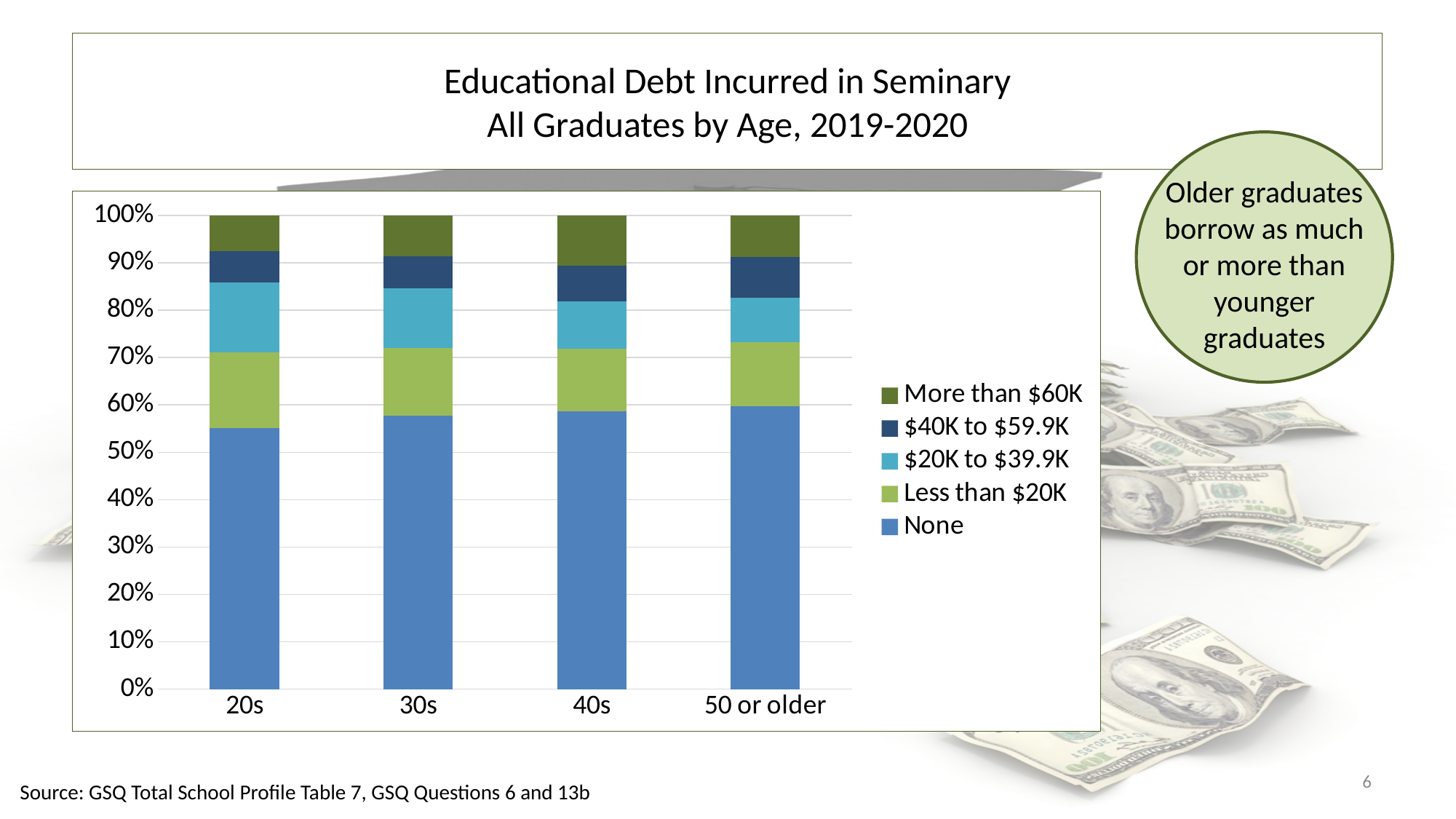
Is the 'None' share for the 50 or older group greater or less than 50%? greater Does the 'None' share rise or fall as age increases from 20s to 50 or older? rise Which age group has the smallest 'None' share? 20s What kind of chart is shown on the slide? Stacked bar chart How many series does the legend list? 5 Is the 'None' share for the 20s group greater or less than 60%? less What is the total of the stacked bar for the 40s group? 100% Is the 'None' share for the 30s group greater or less than 70%? less How many age categories are shown on the x axis? 4 Which series is plotted at the bottom of each stacked bar? None What is the title of the chart? Educational Debt Incurred in Seminary All Graduates by Age, 2019-2020